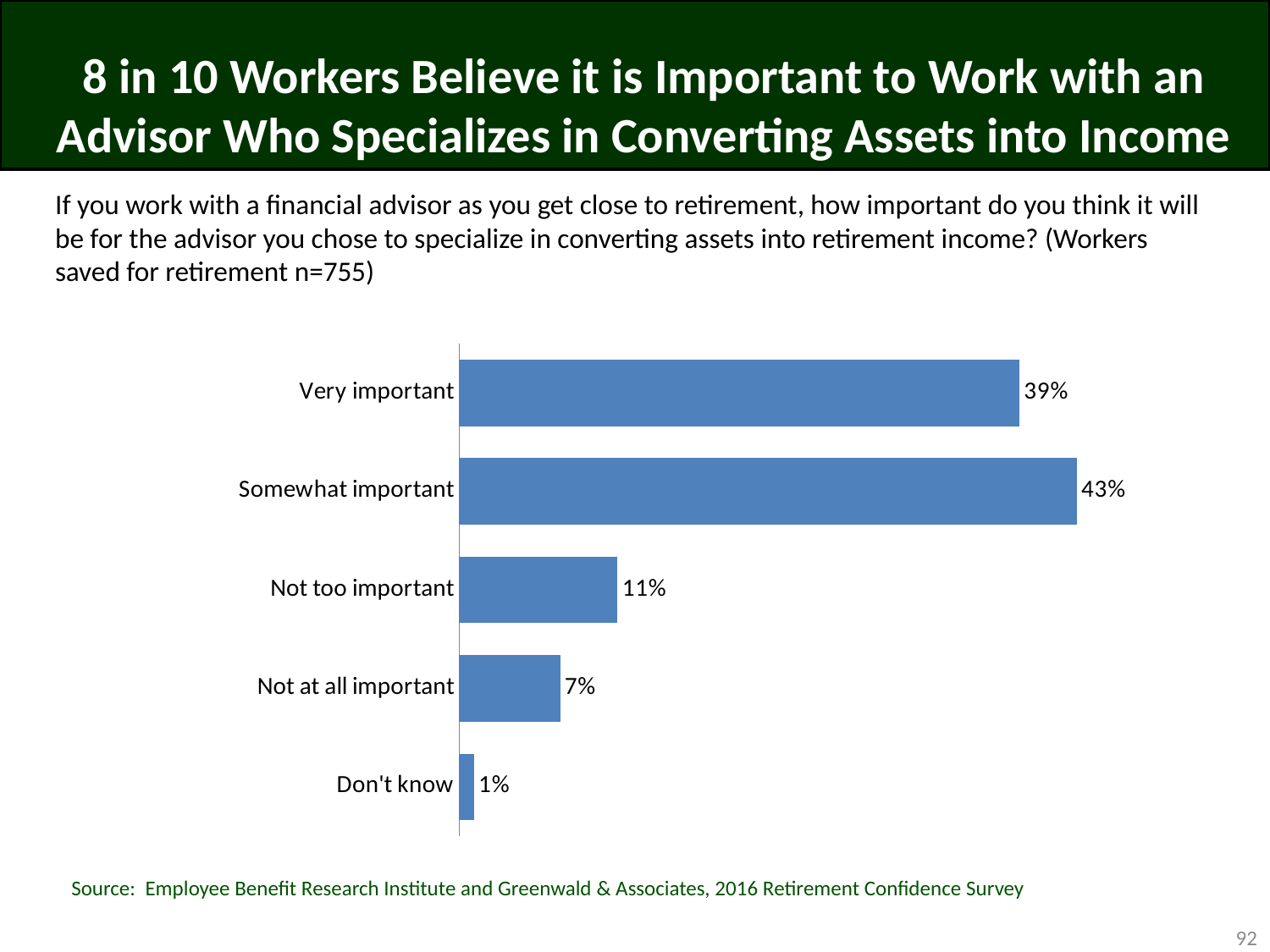
What is the difference between 'Not too important' and 'Not at all important'? 4 percentage points What is the value for 'Don't know'? 1% What is the difference in percentage points between 'Somewhat important' and 'Very important'? 4 percentage points What is the value shown for 'Somewhat important'? 43% What percentage of workers answered 'Not too important'? 11% What type of chart is shown on the slide? Bar chart Which response category has the highest percentage? Somewhat important What percentage of workers said it is very important for the advisor to specialize in converting assets into retirement income? 39% Which is larger, the value for 'Very important' or the value for 'Not too important'? Very important What is the combined percentage of workers who said 'Very important' or 'Somewhat important'? 82% Which response category has the lowest percentage? Don't know How many response categories are shown in the chart? 5